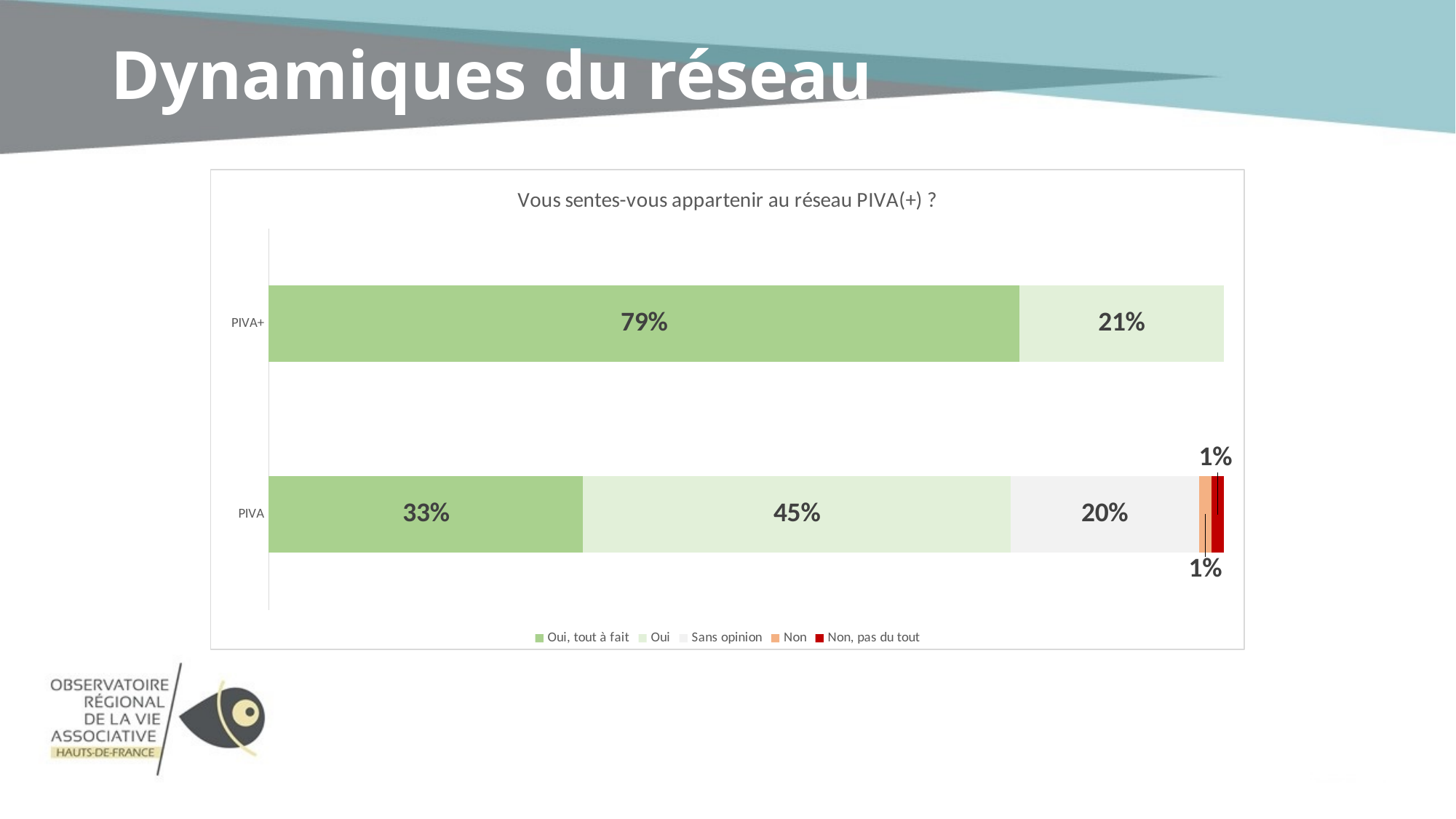
Which category has the higher value for "Oui, tout à fait", PIVA+ or PIVA? PIVA+ What is the value for "Sans opinion" for PIVA? 20% How many categories are shown on the y axis? 2 What kind of chart is this? Stacked bar chart What is the difference between the "Oui" values for PIVA and PIVA+? 24% Which legend entry is shown in red? Non, pas du tout How many series does the legend list? 5 What is the title of the chart? Vous sentes-vous appartenir au réseau PIVA(+) ? What is the value for "Oui, tout à fait" for PIVA+? 79% What is the value for "Oui" for PIVA? 45% What is the value for "Oui" for PIVA+? 21% What is the difference between the "Oui, tout à fait" values for PIVA+ and PIVA? 46%